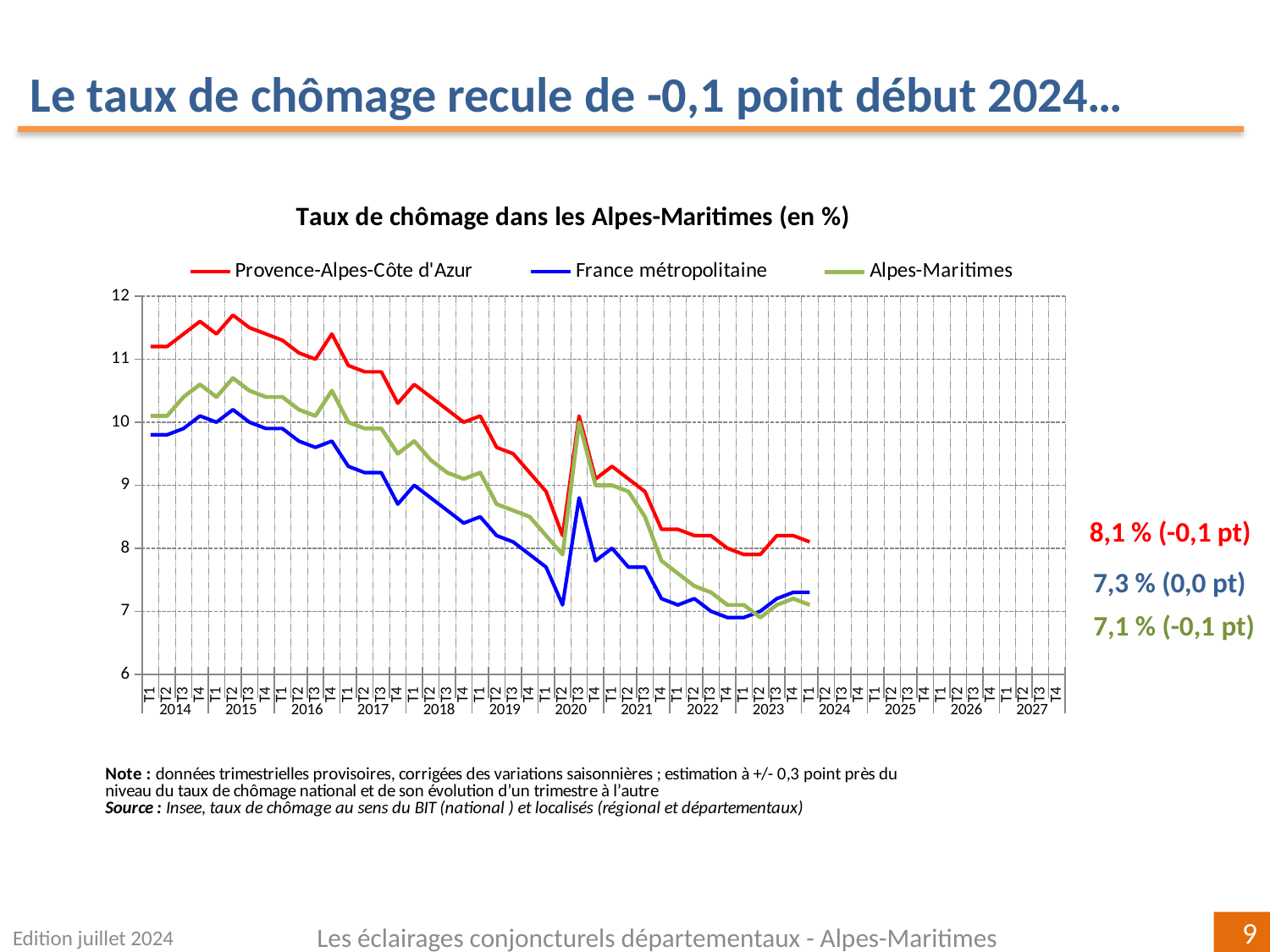
What is the latest unemployment rate shown for France métropolitaine? 7,3 % Which series has the highest values across the whole period? Provence-Alpes-Côte d'Azur What is the title of the chart? Taux de chômage dans les Alpes-Maritimes (en %) What kind of chart is shown on the slide? line chart What is the latest unemployment rate shown for Provence-Alpes-Côte d'Azur? 8,1 % What is the latest unemployment rate shown for Alpes-Maritimes? 7,1 % What is the difference between the latest rates for Provence-Alpes-Côte d'Azur and Alpes-Maritimes? 1,0 point Is the value for Provence-Alpes-Côte d'Azur in T1 2014 greater or less than 11? greater By how much did the Alpes-Maritimes rate change in the latest quarter, according to the annotation? -0,1 pt How many series does the legend list? 3 At the latest point, which is higher: Provence-Alpes-Côte d'Azur or France métropolitaine? Provence-Alpes-Côte d'Azur Overall, do the unemployment rates rise or fall from 2014 to 2024? fall